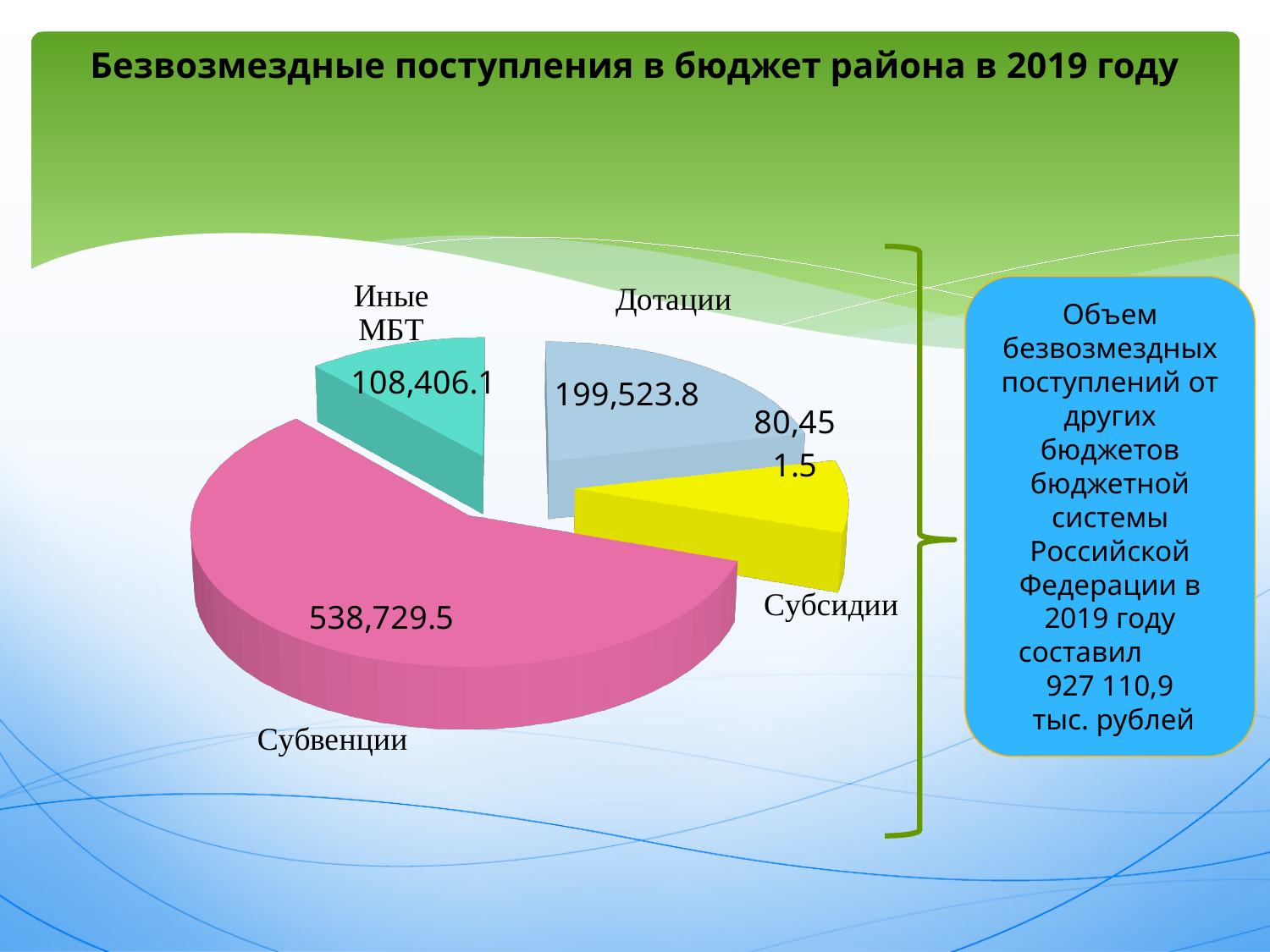
What is the title of the chart on the slide? Безвозмездные поступления в бюджет района в 2019 году Which is larger, Дотации or Иные МБТ? Дотации What is the difference between the values for Дотации and Иные МБТ? 91,117.7 What kind of chart is shown on the slide? Pie chart How many slices does the pie chart have? 4 What is the value for Дотации? 199,523.8 Which category has the largest slice of the pie? Субвенции Which category has the smallest slice of the pie? Субсидии What colour is the Субвенции slice? Pink What is the difference between the values for Субвенции and Дотации? 339,205.7 What is the value for Иные МБТ? 108,406.1 What is the value for Субвенции? 538,729.5